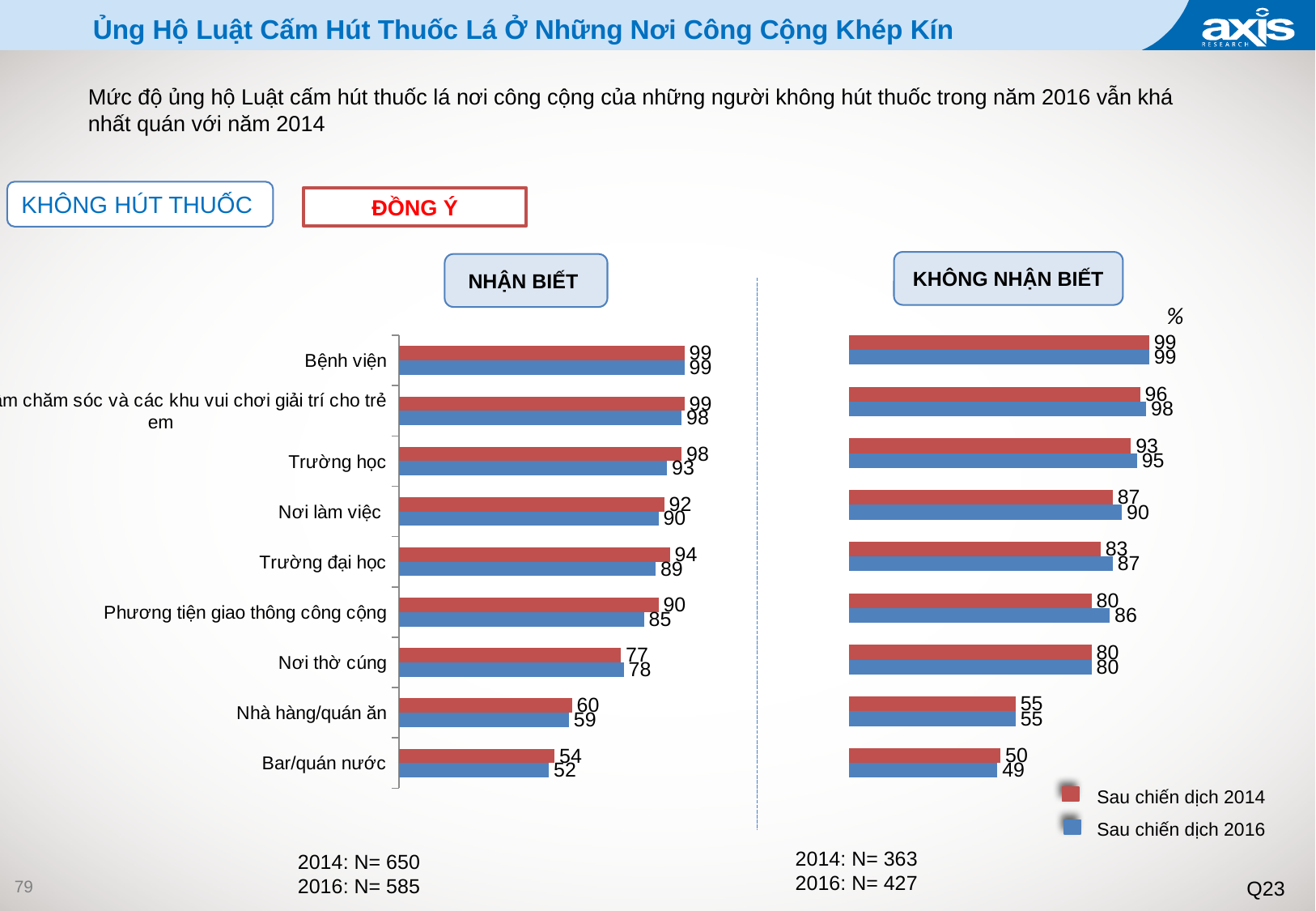
What type of chart is the KHÔNG NHẬN BIẾT chart? Bar chart How many categories are shown in the NHẬN BIẾT chart? 9 In the NHẬN BIẾT chart, what is the value for Trường học for Sau chiến dịch 2016? 93 In the NHẬN BIẾT chart, what is the difference between the Sau chiến dịch 2014 and Sau chiến dịch 2016 values for Trường đại học? 5 How many series does the legend list for the charts on this slide? 2 In the NHẬN BIẾT chart, what is the value for Bar/quán nước for Sau chiến dịch 2014? 54 In the KHÔNG NHẬN BIẾT chart, which category has the lowest value for Sau chiến dịch 2016? Bar/quán nước In the KHÔNG NHẬN BIẾT chart, which is larger for Trường đại học: the Sau chiến dịch 2014 value or the Sau chiến dịch 2016 value? Sau chiến dịch 2016 In the KHÔNG NHẬN BIẾT chart, what is the value for Nơi làm việc for Sau chiến dịch 2014? 87 In the KHÔNG NHẬN BIẾT chart, what is the difference between the Sau chiến dịch 2016 and Sau chiến dịch 2014 values for Phương tiện giao thông công cộng? 6 In the NHẬN BIẾT chart, which is larger for Phương tiện giao thông công cộng: the Sau chiến dịch 2014 value or the Sau chiến dịch 2016 value? Sau chiến dịch 2014 In the NHẬN BIẾT chart, which category has the lowest value for Sau chiến dịch 2014? Bar/quán nước